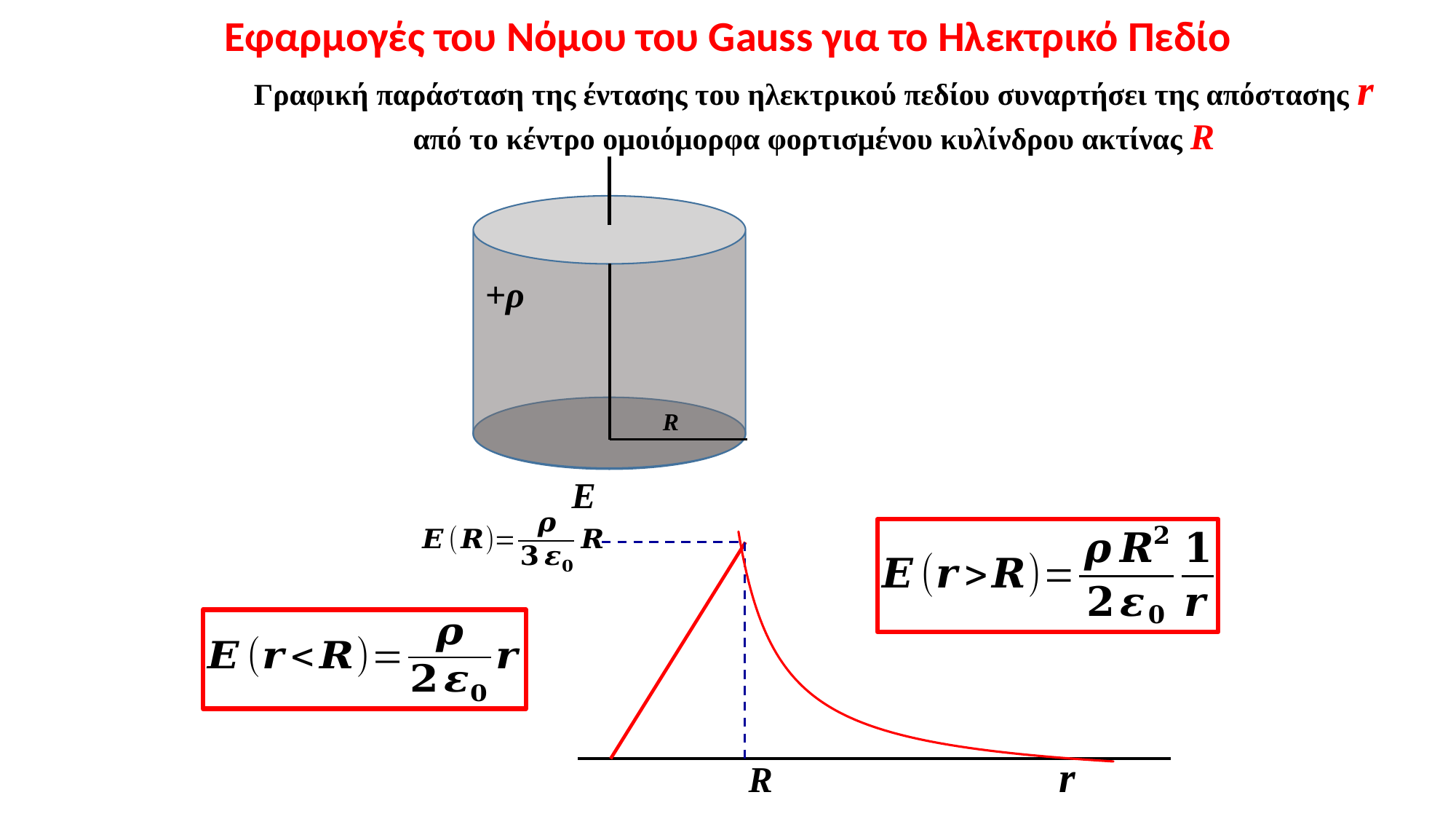
Is the value of E larger at r = R or at a point far to the right of R on the horizontal axis? at r = R What quantity is plotted on the vertical axis of the graph? E Does the curve rise or fall as r increases beyond R? fall At which value of r does the plotted curve reach its maximum? R Is the curve for r < R a straight line or a curved line? straight line Does the curve rise or fall as r increases from 0 to R? rise How many curves are plotted on the graph? 1 What quantity is plotted on the horizontal axis of the graph? r According to the label on the vertical axis, what is the value of E at r = R? E(R) = ρR/(3ε0) What kind of chart is shown at the bottom of the slide? line chart